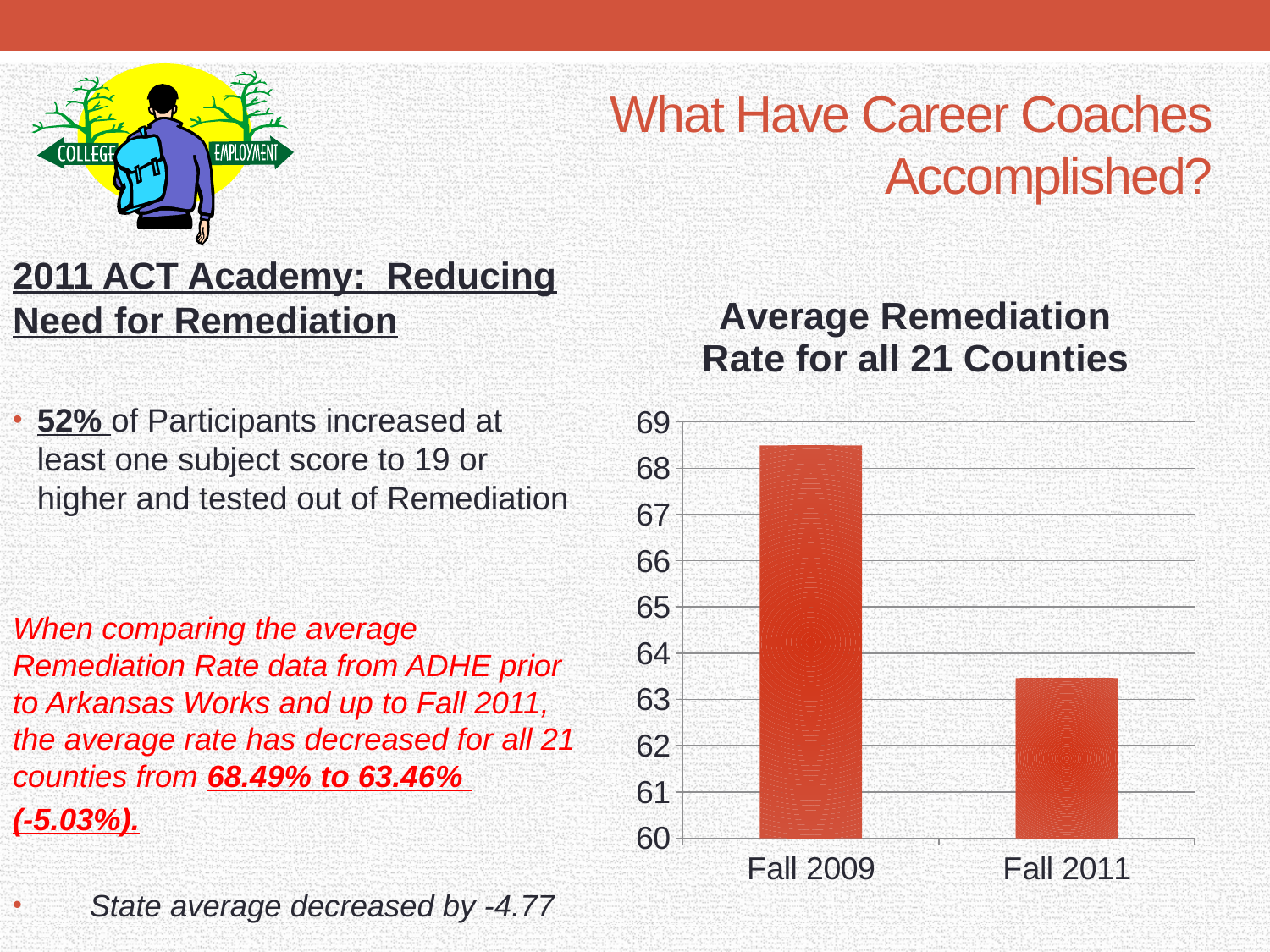
Is the value for Fall 2011 greater or less than 64? less Is the value for Fall 2009 greater or less than 69? less Which is larger, the value for Fall 2009 or the value for Fall 2011? Fall 2009 Do the values rise or fall from Fall 2009 to Fall 2011? fall Which category has the lowest average remediation rate? Fall 2011 How many categories are shown on the x axis of the chart? 2 Which category has the highest average remediation rate? Fall 2009 Is the value for Fall 2011 greater or less than 63? greater What is the lowest value shown on the chart's vertical axis? 60 What type of chart is shown on the slide? bar chart What is the title of the chart? Average Remediation Rate for all 21 Counties